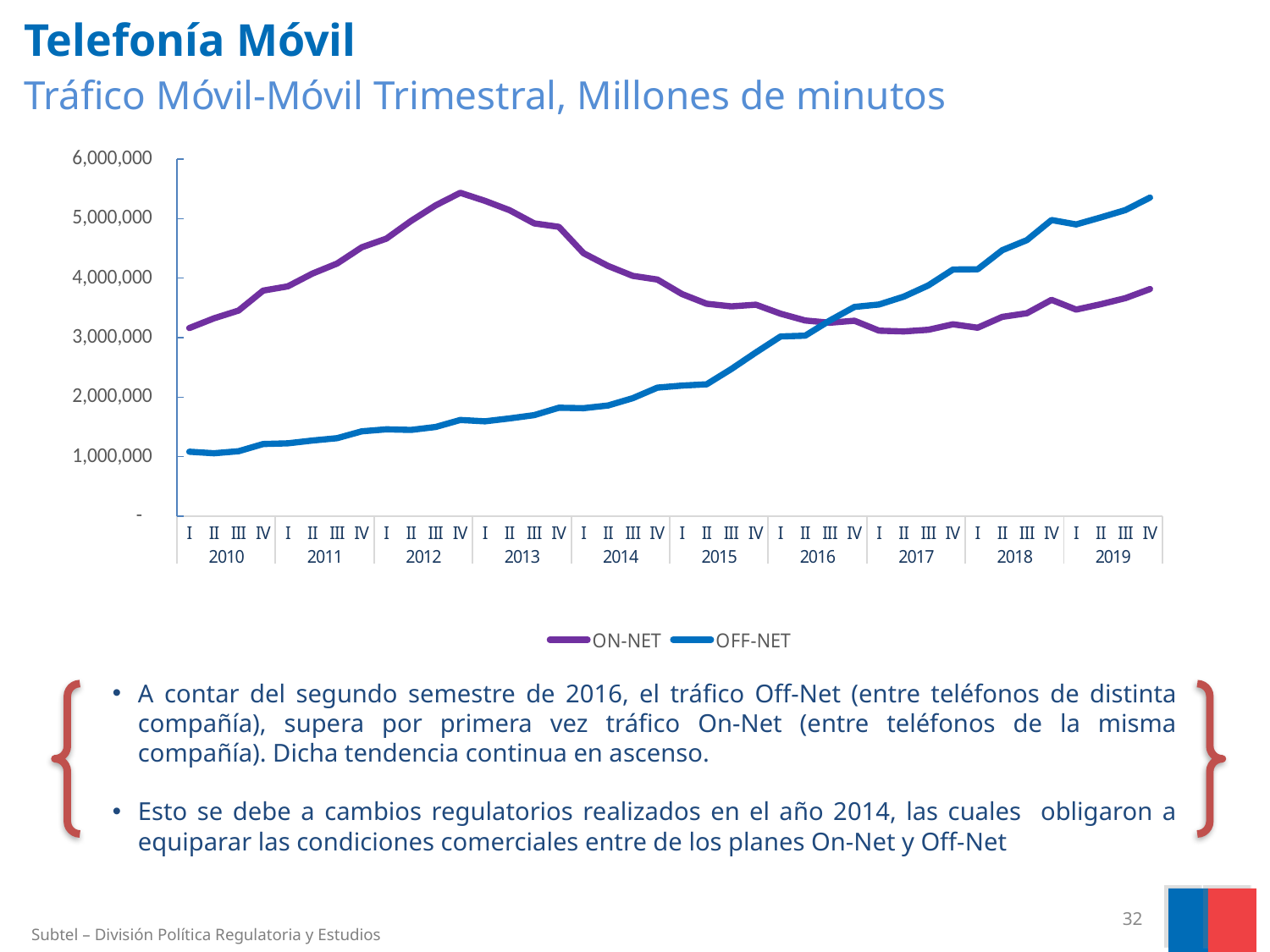
Which series has the larger value in quarter IV of 2012, ON-NET or OFF-NET? ON-NET Is the ON-NET value for quarter IV of 2019 greater or less than 4,000,000? less Is the OFF-NET value for quarter IV of 2019 greater or less than 5,000,000? greater How many years are shown along the x axis? 10 Does the OFF-NET series generally rise or fall from 2010 to 2019? rise How many series does the legend list? 2 In which year does the ON-NET series reach its highest value? 2012 Which series has the larger value in quarter IV of 2019, ON-NET or OFF-NET? OFF-NET Is the ON-NET value for quarter IV of 2012 greater or less than 5,000,000? greater How many quarterly data points does each series have? 40 What kind of chart is shown on the slide? line chart